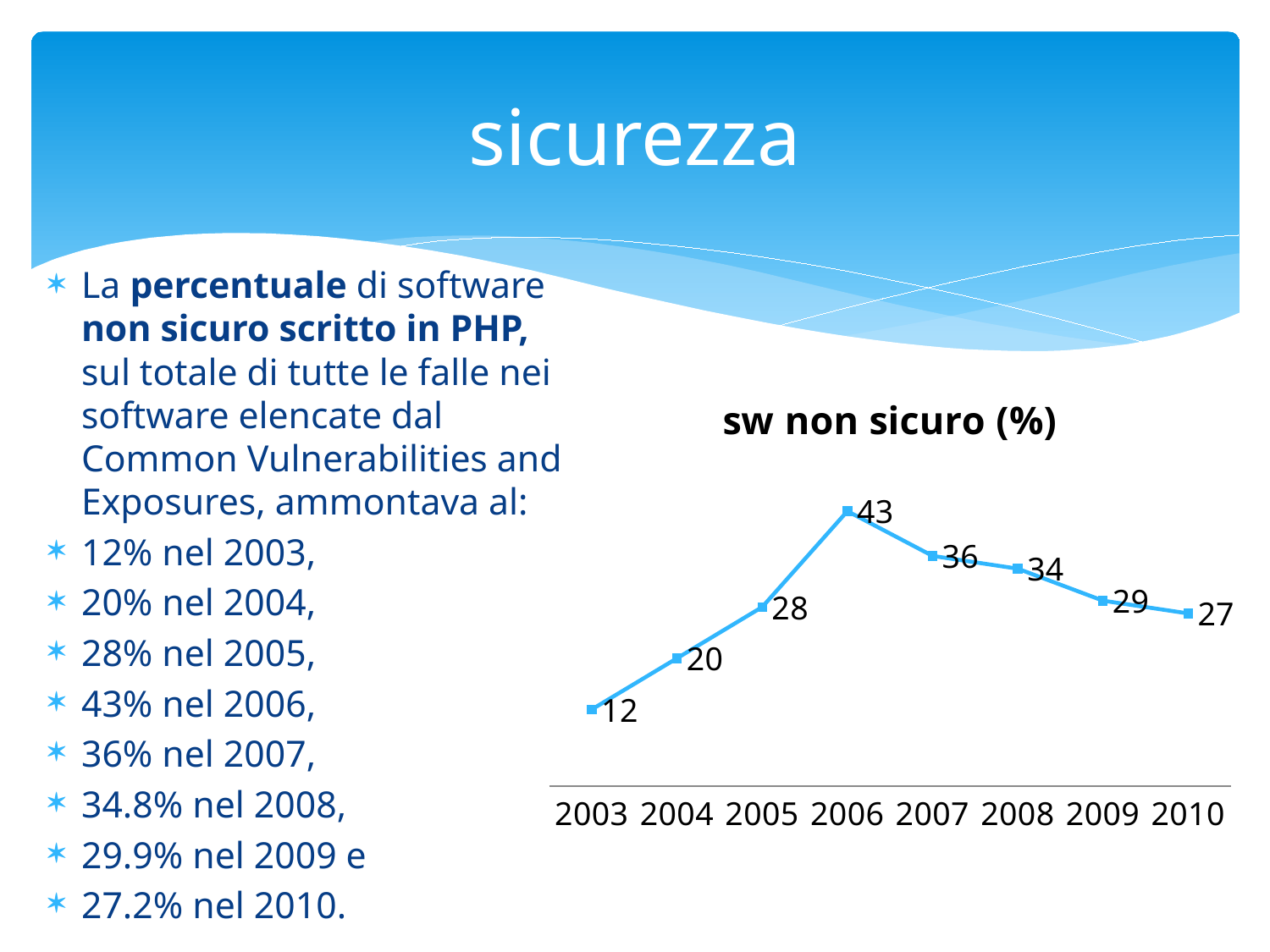
Which year has the lowest value in the chart? 2003 Do the values rise or fall from 2006 to 2010? fall How many years are plotted on the x axis of the chart? 8 What is the value for 2003 in the chart? 12 What is the difference between the values for 2007 and 2009? 7 What is the value for 2010 in the chart? 27 What kind of chart is shown on the slide? line chart Which is larger, the value for 2005 or the value for 2009? 2009 What is the difference between the values for 2006 and 2003? 31 Which year has the highest value in the chart? 2006 What is the value for 2008 in the chart? 34 What is the value for 2006 in the chart? 43